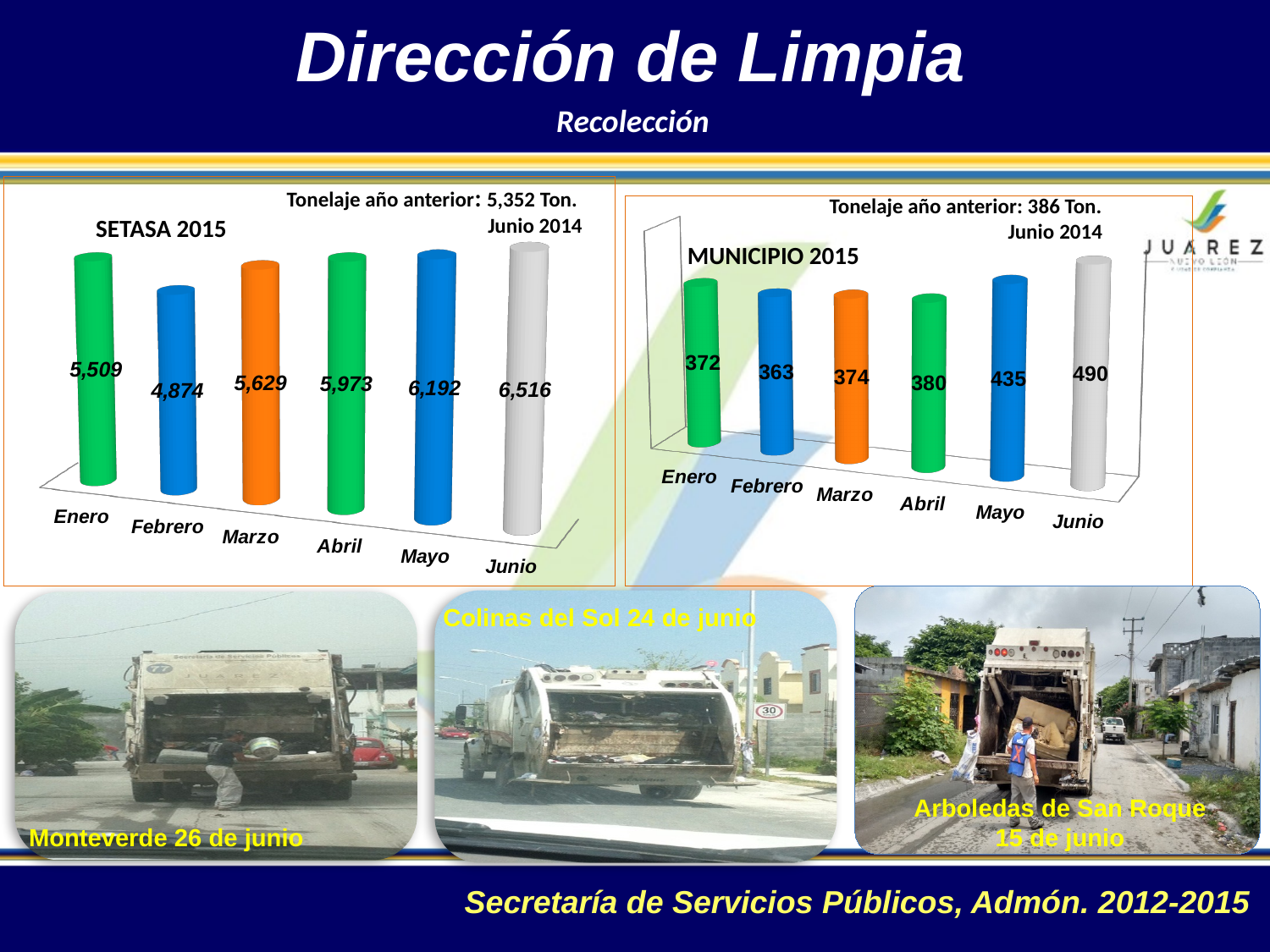
In the MUNICIPIO 2015 chart, what is the difference between the values for Junio and Mayo? 55 In the SETASA 2015 chart, which month has the highest value? Junio What is the 'Tonelaje año anterior' figure shown above the SETASA 2015 chart? 5,352 Ton. How many months are plotted in the MUNICIPIO 2015 chart? 6 In the MUNICIPIO 2015 chart, do the values generally rise or fall from Marzo to Junio? Rise In the SETASA 2015 chart, what is the difference between the values for Junio and Enero? 1,007 In the MUNICIPIO 2015 chart, which month has the lowest value? Febrero In the MUNICIPIO 2015 chart, which is larger, the value for Enero or the value for Abril? Abril In the SETASA 2015 chart, which is larger, the value for Marzo or the value for Abril? Abril In the MUNICIPIO 2015 chart, what is the value for Mayo? 435 In the SETASA 2015 chart, what is the value for Febrero? 4,874 What kind of chart is the SETASA 2015 chart? Bar chart